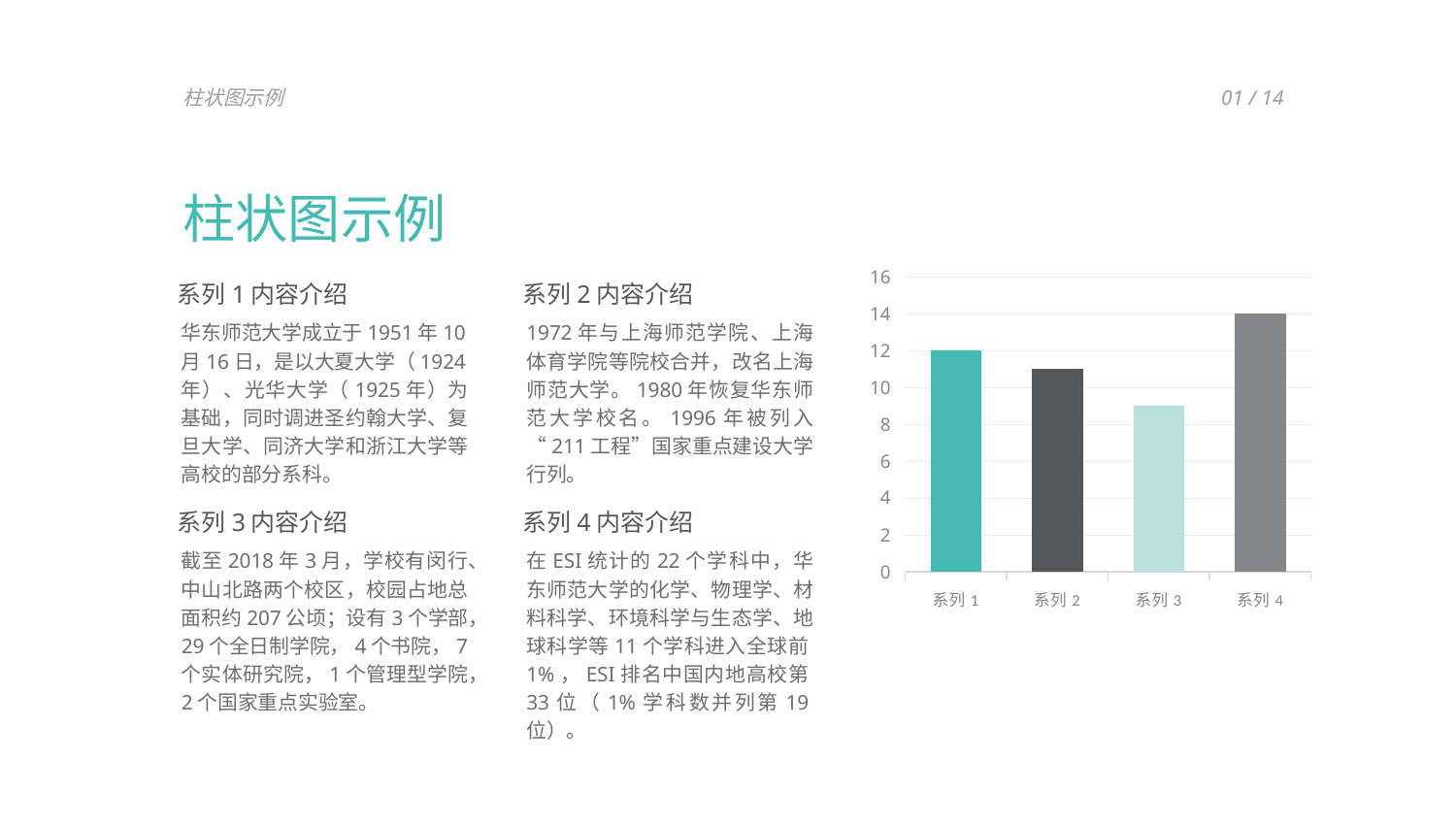
What is the highest value shown on the y axis? 16 Which is larger, the value for 系列 1 or the value for 系列 3? 系列 1 Is the value for 系列 2 greater or less than 10? greater What is the value for 系列 4? 14 Is the value for 系列 3 greater or less than 10? less What type of chart is shown on the slide? Bar chart How many categories are shown on the x axis of the chart? 4 What is the value for 系列 1? 12 Which category has the lowest value? 系列 3 What is the difference between the values for 系列 4 and 系列 1? 2 Which category has the highest value? 系列 4 What colour is the bar for 系列 1? Teal